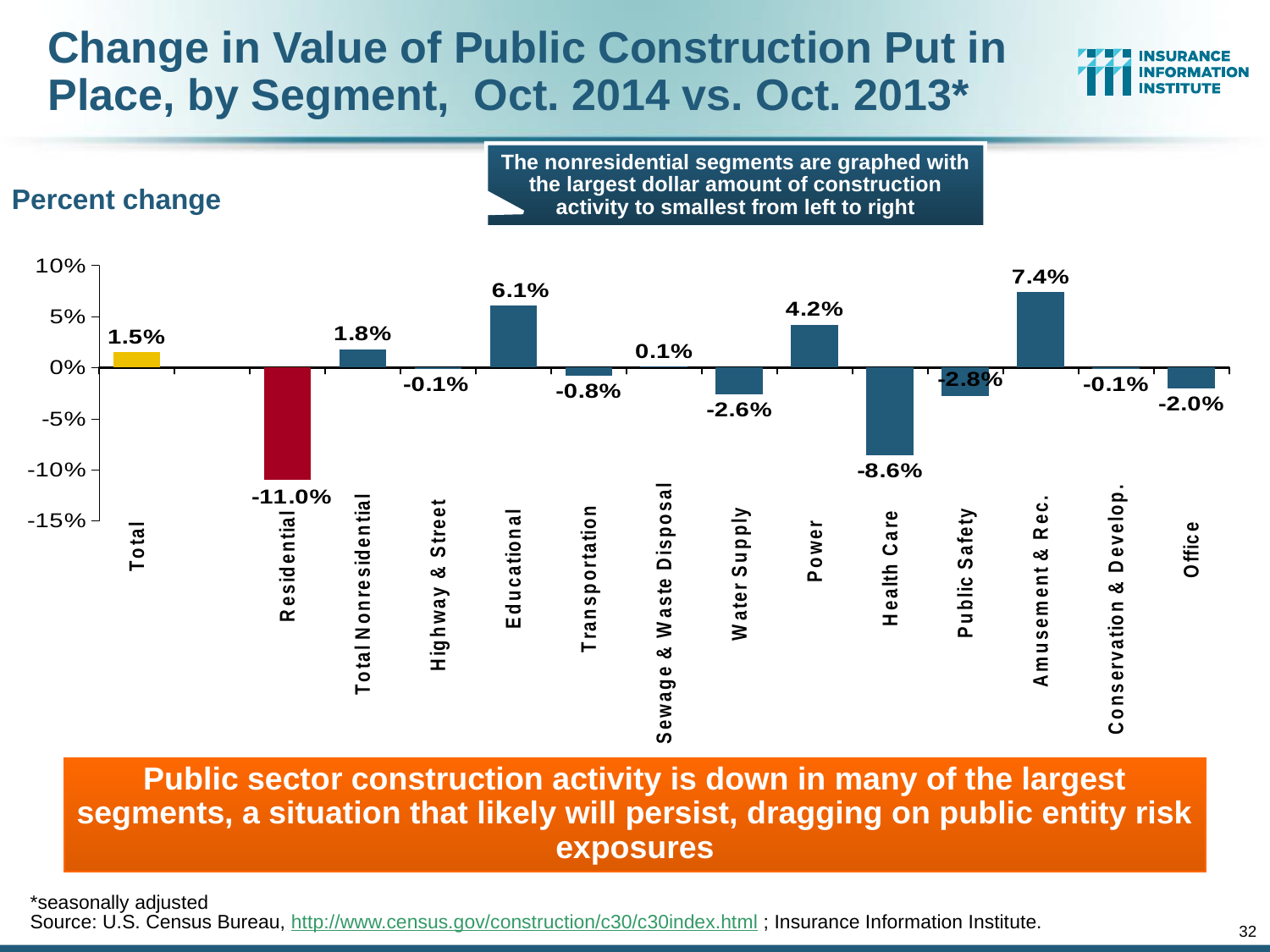
Which has a larger percent change, Power or Educational? Educational Which segment has the highest percent change? Amusement & Rec. What is the percent change for Health Care? -8.6% What colour is the bar for Residential? Red How many categories are shown on the x axis? 14 Which segment has the lowest percent change? Residential What is the percent change for Total Nonresidential? 1.8% What is the percent change for Educational? 6.1% What kind of chart is shown on the slide? Bar chart What is the difference in percentage points between the Amusement & Rec. value and the Educational value? 1.3 percentage points Is the value for Health Care greater or less than -5%? less What is the percent change for Residential? -11.0%